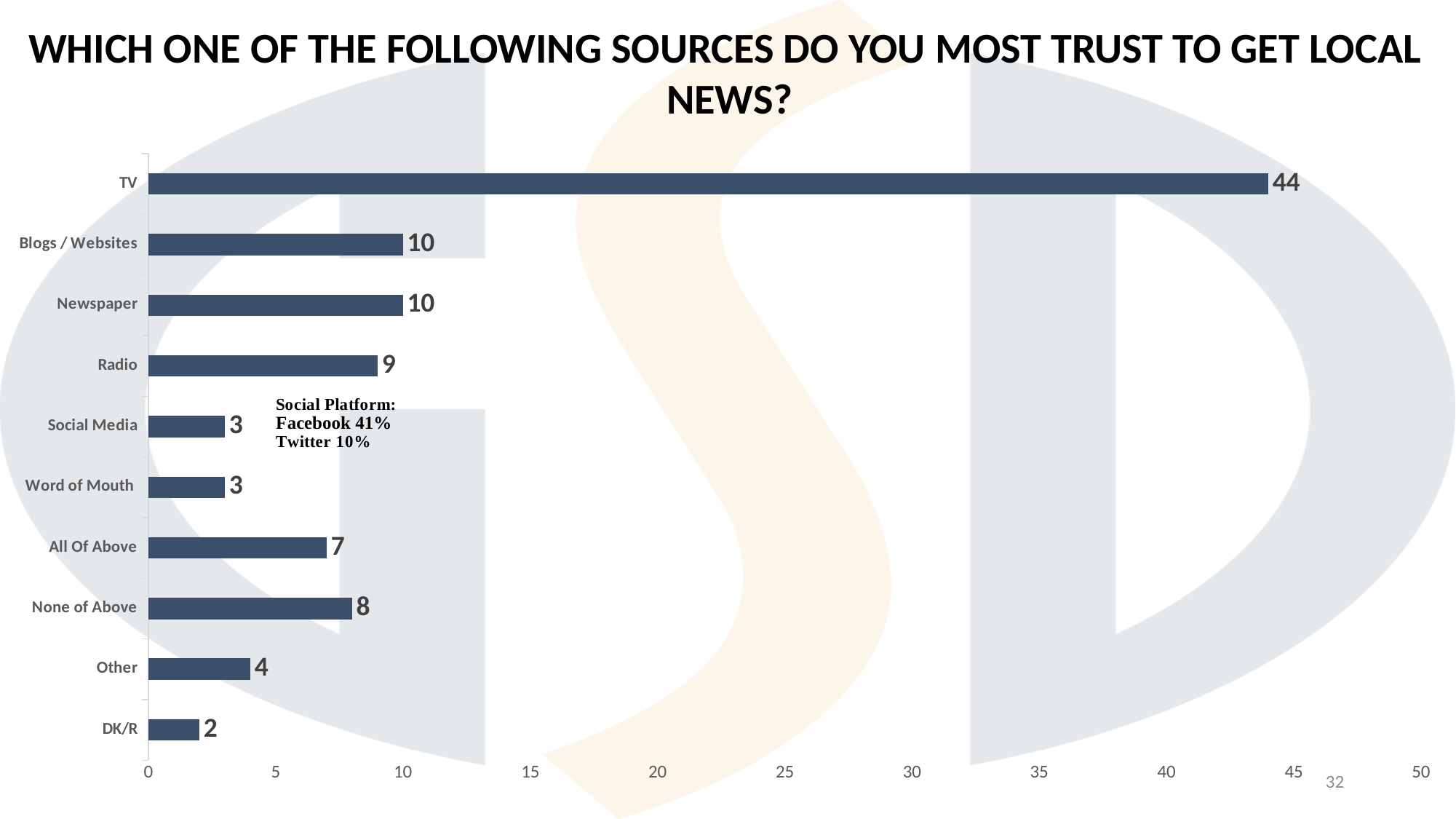
What is the value for TV? 44 Which category has the lowest value? DK/R According to the text annotation on the chart, what percentage is given for Facebook under Social Platform? 41% Is the value for TV greater or less than 40? greater What is the value for DK/R? 2 Which source has the highest value? TV Which is larger, the value for All Of Above or the value for None of Above? None of Above What is the value for None of Above? 8 What is the difference between the values for TV and Newspaper? 34 What kind of chart is shown on the slide? Bar chart What is the value for Radio? 9 How many categories are shown on the chart? 10